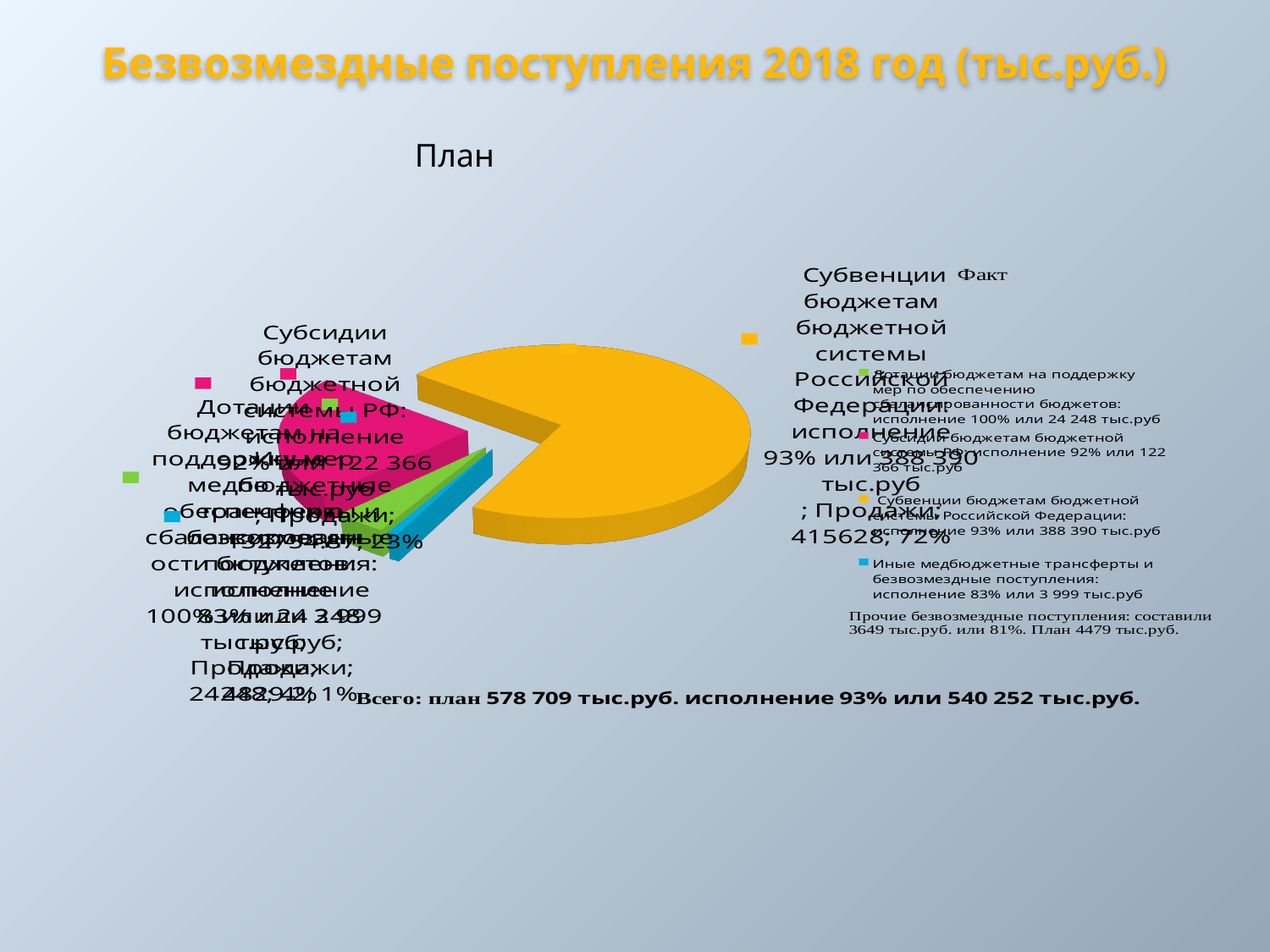
How many slices does the pie chart have? 4 According to the legend, what is the execution amount for Субвенции бюджетам бюджетной системы Российской Федерации? 388 390 тыс.руб How many entries does the chart legend list? 4 What share of the pie is the slice for Субвенции бюджетам бюджетной системы Российской Федерации? 72% Which slice is larger: Субвенции бюджетам бюджетной системы or Субсидии бюджетам бюджетной системы? Субвенции бюджетам бюджетной системы What is the title of the chart? План What kind of chart is shown on the slide? pie chart What share of the pie is the slice for Субсидии бюджетам бюджетной системы РФ? 23% What colour is the largest slice of the pie? yellow According to the legend, what is the execution percentage for Дотации бюджетам на поддержку мер по обеспечению сбалансированности бюджетов? 100% Which category has the largest slice of the pie? Субвенции бюджетам бюджетной системы Российской Федерации Which category has the smallest slice of the pie? Иные медбюджетные трансферты и безвозмездные поступления